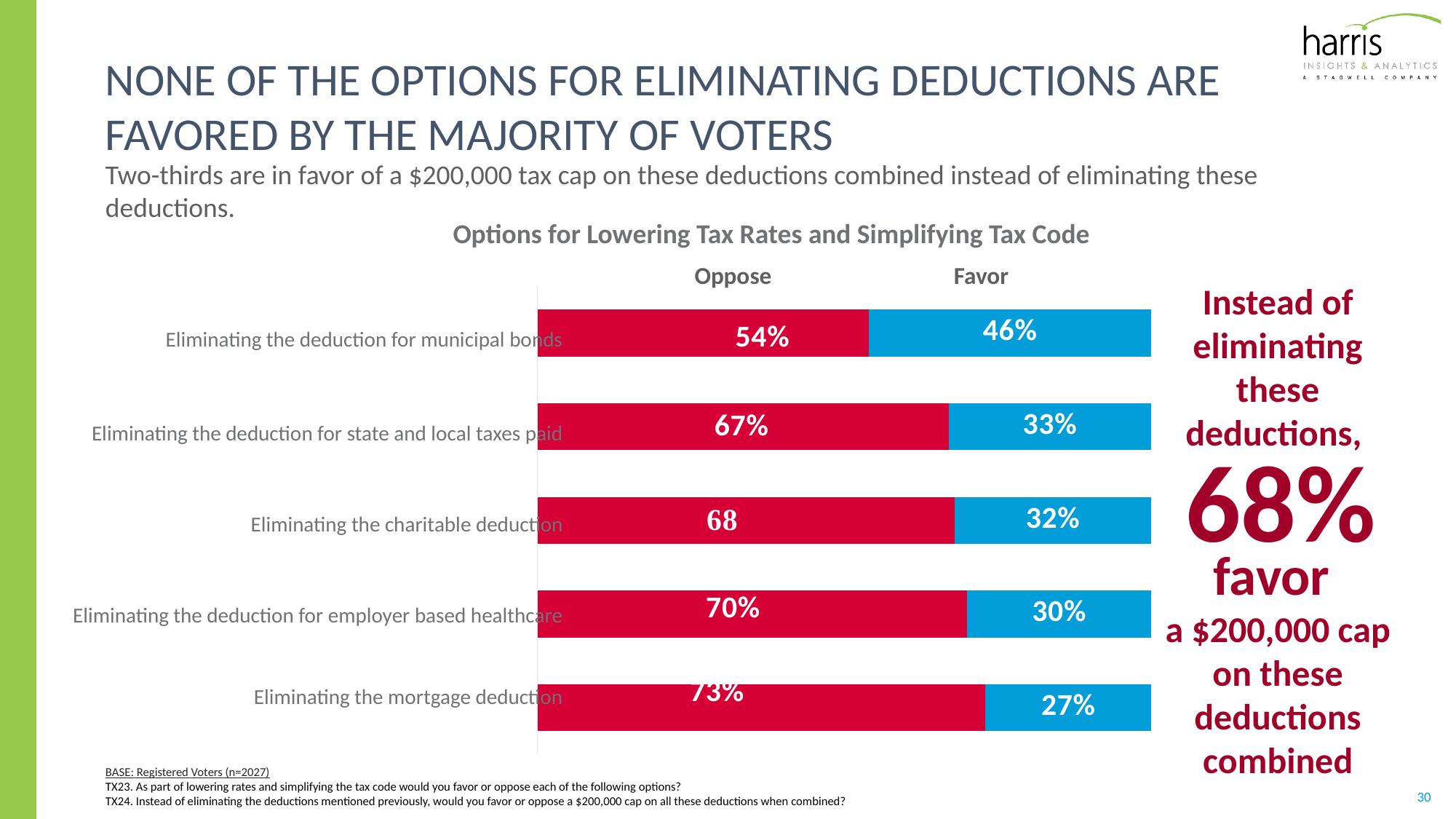
Which option has the highest share of voters in favor of it? Eliminating the deduction for municipal bonds How many options are shown in the chart? 5 What percentage of voters oppose eliminating the deduction for employer based healthcare? 70% What is the difference between the Oppose and Favor percentages for eliminating the deduction for employer based healthcare? 40 percentage points How many series does the chart show? 2 Which option has the lowest share of voters in favor of it? Eliminating the mortgage deduction What type of chart is used on this slide? Stacked bar chart Which option has the highest share of voters opposing it? Eliminating the mortgage deduction Is the Favor share larger for eliminating the deduction for municipal bonds or for eliminating the charitable deduction? Eliminating the deduction for municipal bonds What percentage of voters oppose eliminating the deduction for municipal bonds? 54% What percentage of voters favor eliminating the deduction for state and local taxes paid? 33% What percentage of voters favor eliminating the mortgage deduction? 27%